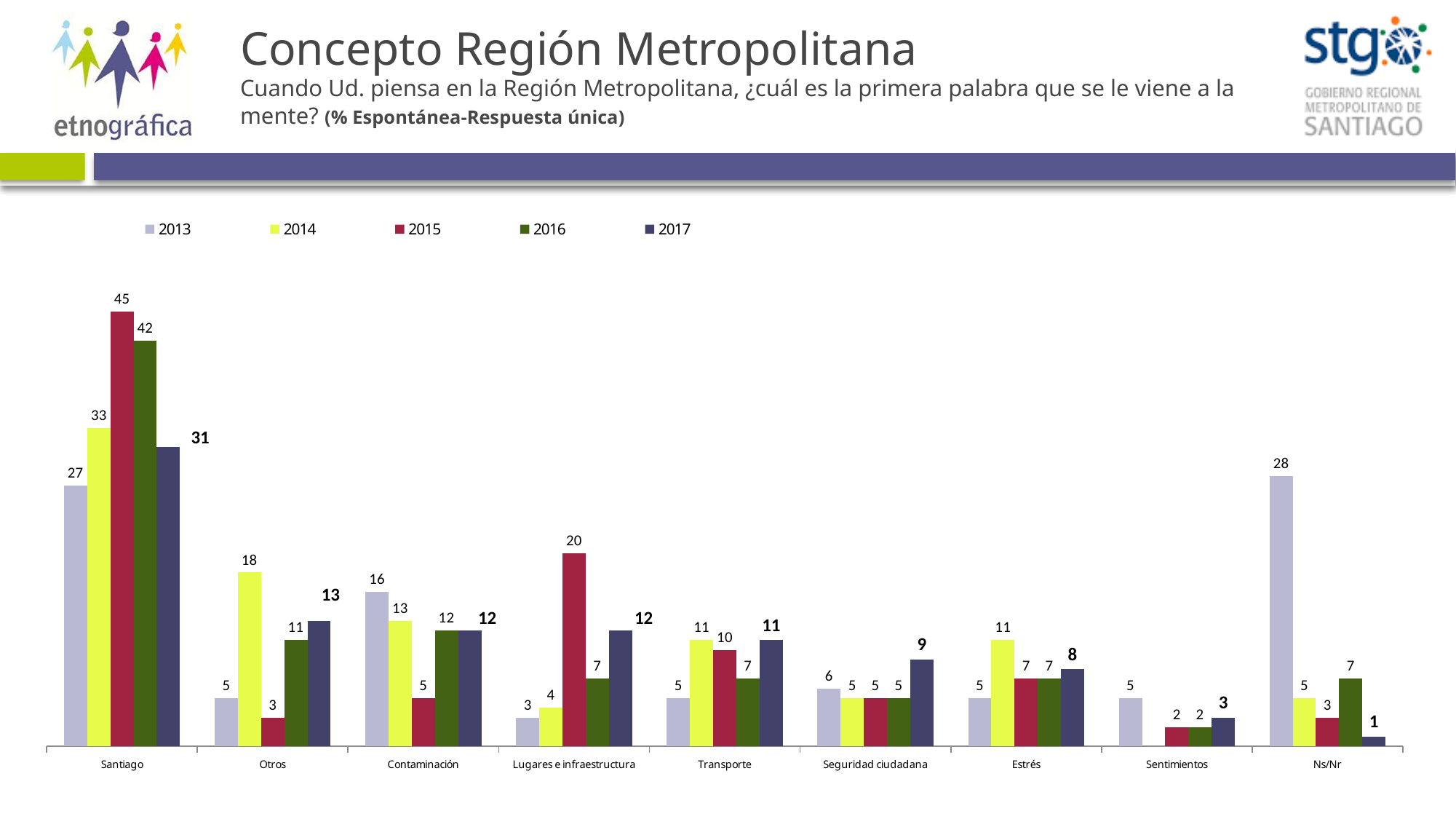
What is the value for Santiago in 2015? 45 Which category has the lowest value in 2017? Ns/Nr What is the value for Lugares e infraestructura in 2017? 12 Which year is shown in the legend with a yellow-green colour? 2014 What kind of chart is shown on the slide? bar chart What is the value for Ns/Nr in 2013? 28 What is the difference between the 2015 and 2017 values for Santiago? 14 Did the value for Ns/Nr rise or fall from 2013 to 2017? fall How many series does the legend list? 5 Which category has the highest value in 2017? Santiago Which is larger for Otros: the 2014 value or the 2017 value? 2014 How many categories are shown on the x axis? 9